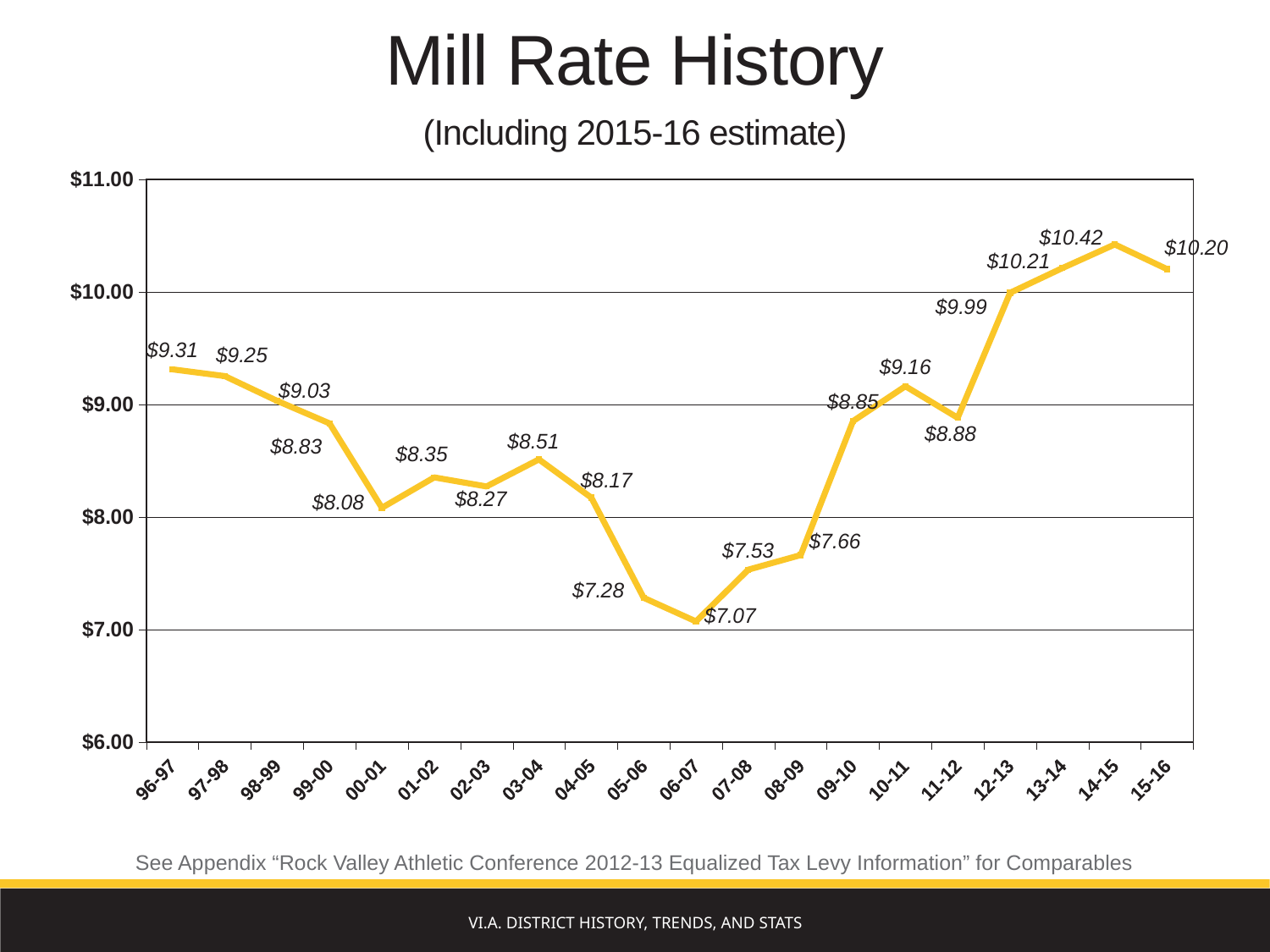
Which year has the lowest mill rate? 06-07 What is the mill rate for 96-97? $9.31 Is the mill rate for 09-10 greater or less than $9.00? less What is the difference between the mill rate in 14-15 and the mill rate in 15-16? $0.22 What kind of chart is shown on the slide? line chart Does the mill rate rise or fall from 96-97 to 00-01? fall Which year has the highest mill rate? 14-15 What is the estimated mill rate for 15-16? $10.20 What is the mill rate for 12-13? $9.99 What is the mill rate for 06-07? $7.07 Which is larger, the mill rate for 00-01 or the mill rate for 01-02? 01-02 How many school years are plotted on the chart? 20